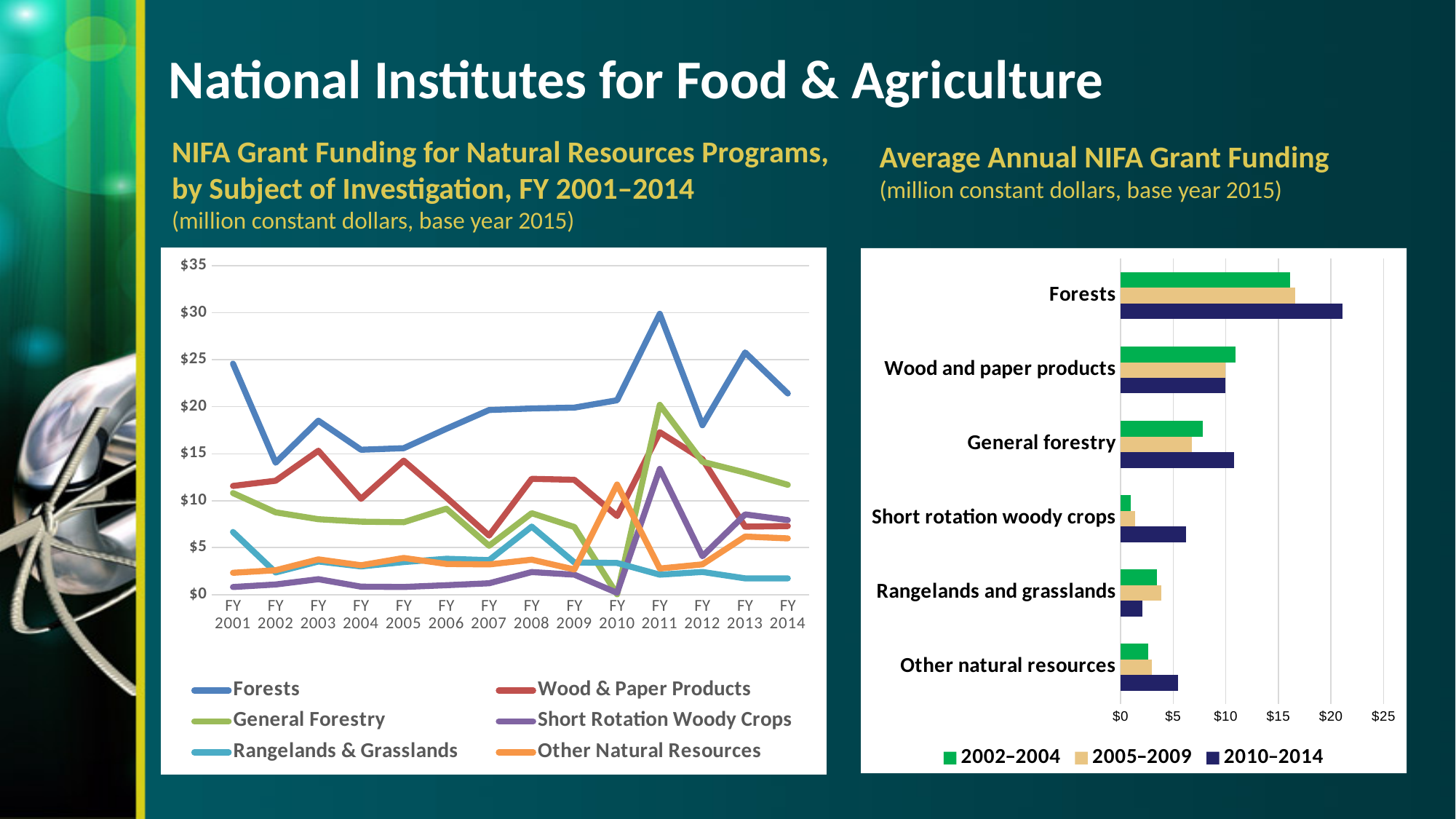
In the bar chart on the right, is the value for Forests in 2010–2014 greater or less than $20? greater In the line chart on the left, which series has the highest value in FY 2011? Forests In the bar chart on the right, how many series does the legend list? 3 In the line chart on the left, is the value for Short Rotation Woody Crops in FY 2001 greater or less than $5? less In the bar chart on the right, how many categories are shown? 6 In the bar chart on the right, which category has the highest value for 2010–2014? Forests In the line chart on the left, how many fiscal years are plotted along the x axis? 14 In the line chart on the left, which is larger in FY 2014: Forests or General Forestry? Forests What kind of chart is the chart titled "NIFA Grant Funding for Natural Resources Programs, by Subject of Investigation, FY 2001–2014"? line chart What kind of chart is the chart titled "Average Annual NIFA Grant Funding"? bar chart In the line chart on the left, is the value for Forests in FY 2011 greater or less than $25? greater In the line chart on the left, how many series does the legend list? 6